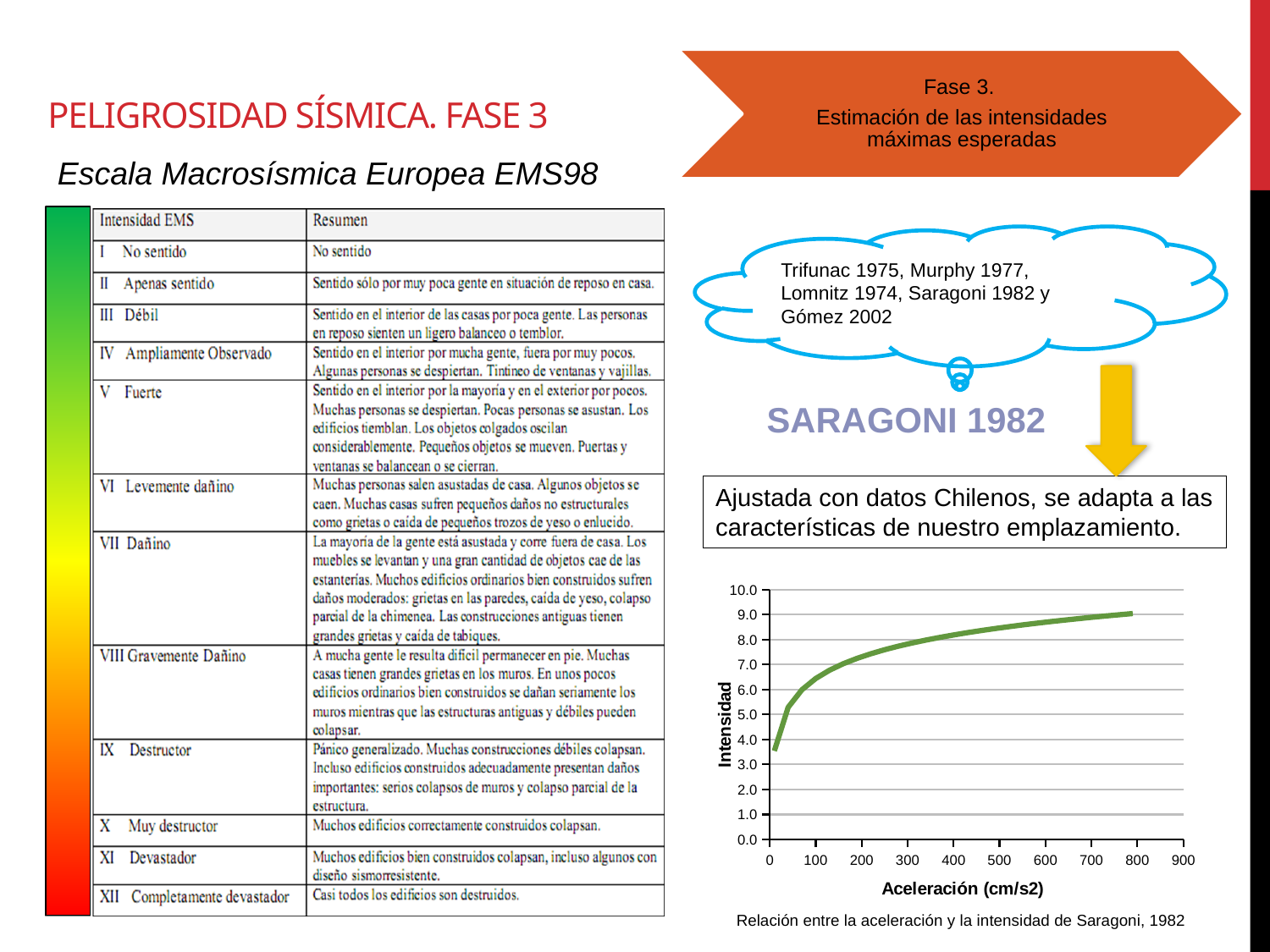
In the chart of Intensidad versus Aceleración, does the intensity rise or fall as acceleration increases? rise In the chart, is the intensity at an acceleration of 100 cm/s2 greater or less than 5.0? greater What is the highest tick value shown on the vertical axis of the chart? 10.0 In the chart, is the intensity at an acceleration of 300 cm/s2 greater or less than 9.0? less In the chart, is the intensity at an acceleration of 700 cm/s2 greater or less than 8.0? greater What is the label of the horizontal axis of the chart? Aceleración (cm/s2) What kind of chart is shown at the bottom right of the slide? line chart What is the label of the vertical axis of the chart? Intensidad What is the highest tick value shown on the horizontal axis of the chart? 900 In the chart, is the intensity higher at an acceleration of 800 cm/s2 or at 200 cm/s2? 800 cm/s2